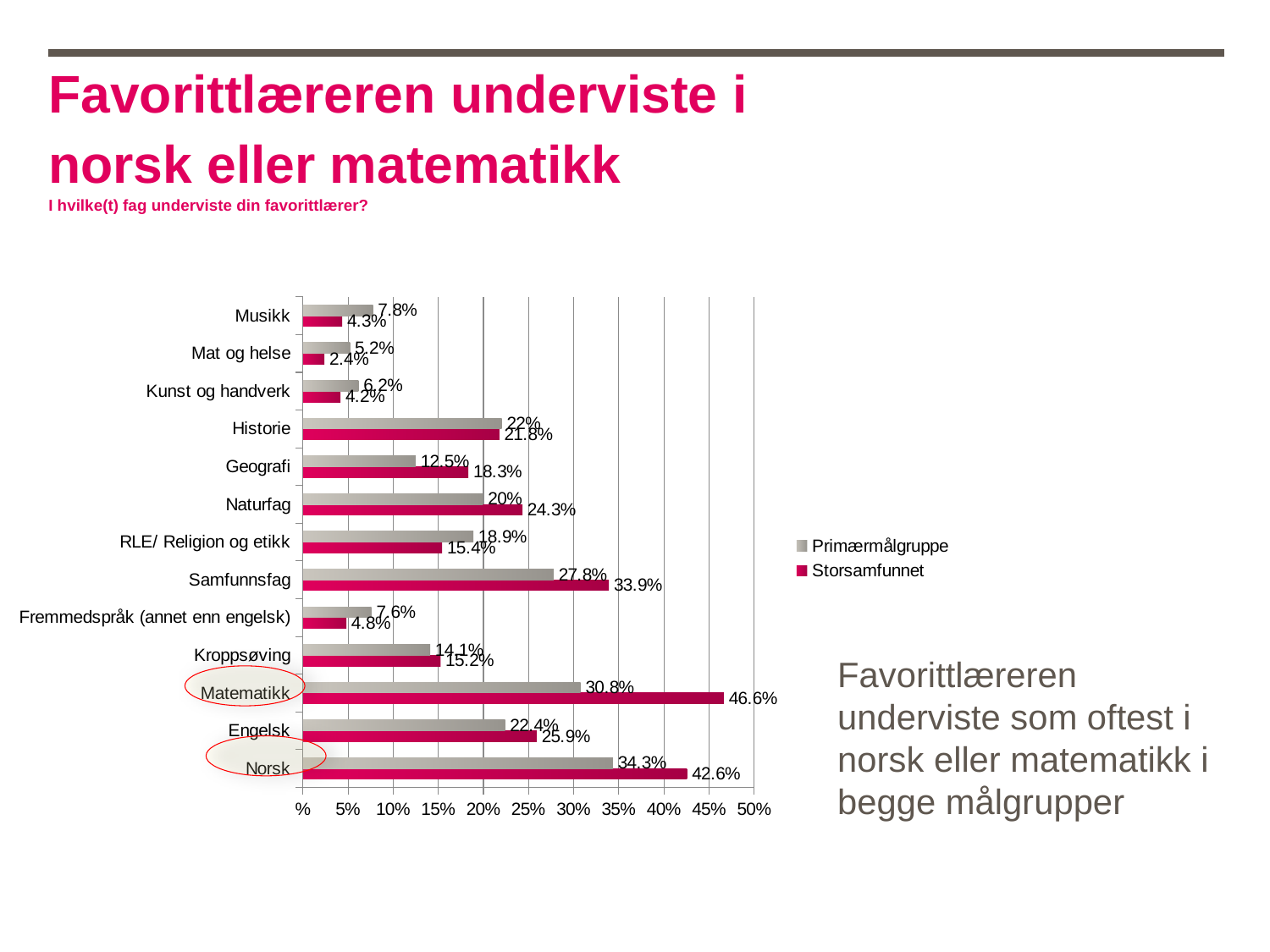
How many series does the legend list? 2 Which subject has the lowest Storsamfunnet value? Mat og helse Which series is shown in magenta in the legend? Storsamfunnet Which subject has the highest Storsamfunnet value? Matematikk What is the Storsamfunnet value for Samfunnsfag? 33.9% What is the difference between the Storsamfunnet and Primærmålgruppe values for Matematikk? 15.8 percentage points What is the Storsamfunnet value for Matematikk? 46.6% For Geografi, which series has the larger value, Primærmålgruppe or Storsamfunnet? Storsamfunnet Which subject has the highest Primærmålgruppe value? Norsk How many subject categories are plotted on the chart? 13 What type of chart is shown on the slide? Bar chart What is the Primærmålgruppe value for Norsk? 34.3%